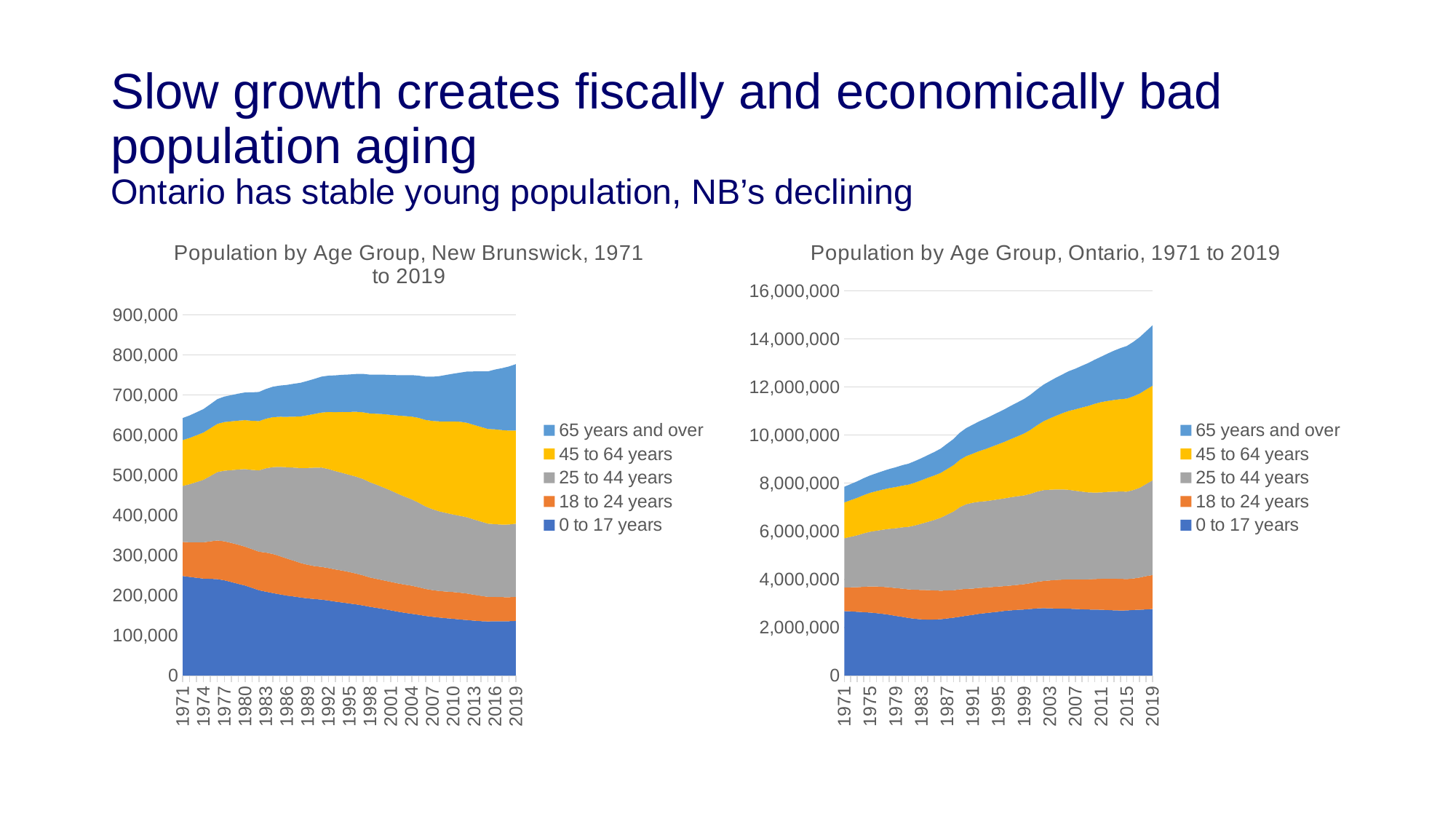
On the New Brunswick chart, is the value for 0 to 17 years in 2019 greater or less than 200,000? less On the New Brunswick chart, is the total population in 1971 greater or less than 600,000? greater On the Ontario chart, is the value for 0 to 17 years in 2019 greater or less than 2,000,000? greater What is the title of the chart on the right side of the slide? Population by Age Group, Ontario, 1971 to 2019 On the New Brunswick chart, does the 0 to 17 years series rise or fall from 1971 to 2019? fall How many series does the legend list on the Population by Age Group, Ontario, 1971 to 2019 chart? 5 What kind of chart is the Population by Age Group, New Brunswick, 1971 to 2019 chart? stacked area chart Which age group is listed first in the legend of the Ontario chart? 65 years and over On the Ontario chart, does the total population rise or fall from 1971 to 2019? rise